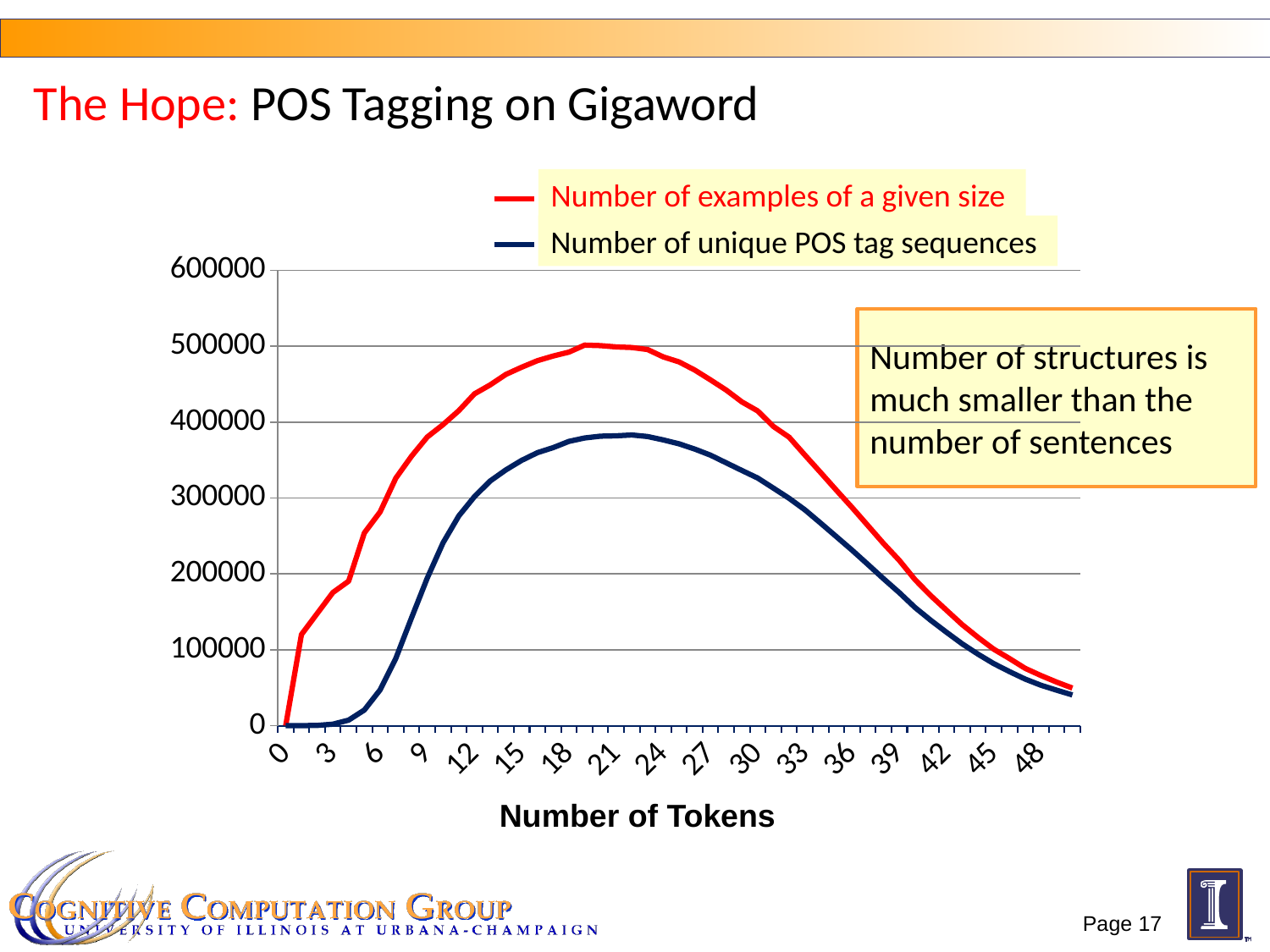
Does the Number of examples of a given size rise or fall as the number of tokens increases from 24 to 48? fall Which series reaches the higher peak value? Number of examples of a given size At 21 tokens, which series has the larger value: Number of examples of a given size or Number of unique POS tag sequences? Number of examples of a given size Is the value of Number of examples of a given size at 42 tokens greater or less than 100000? greater Is the value of Number of unique POS tag sequences at 6 tokens greater or less than 100000? less Is the value of Number of examples of a given size at 6 tokens greater or less than 300000? less What kind of chart is shown on the slide? line chart What is the title of the x axis? Number of Tokens Which series is drawn in red? Number of examples of a given size How many series does the legend list? 2